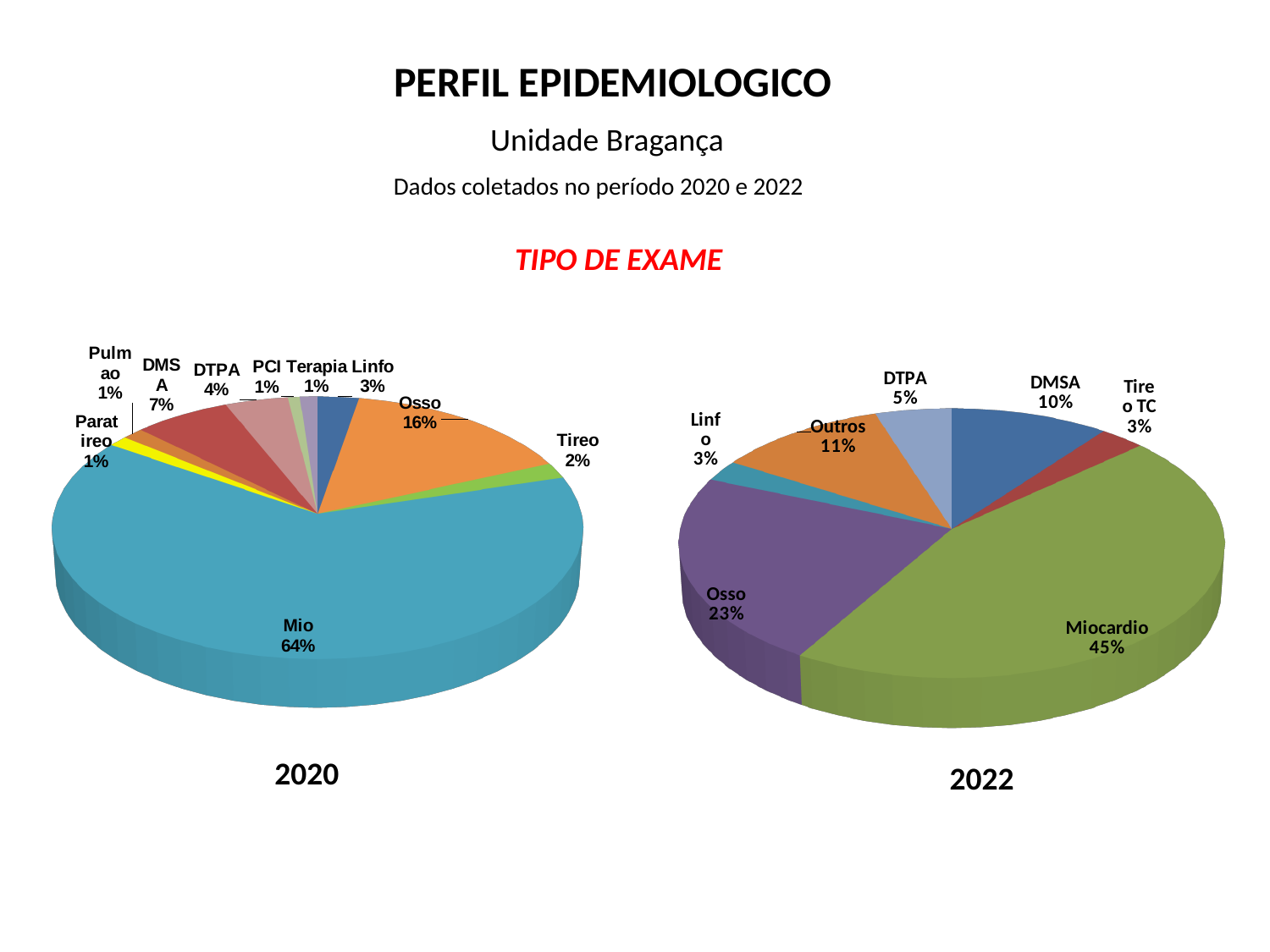
In the 2020 chart, how many slices does the pie have? 10 In the 2022 chart, what share does Outros have? 11% In the 2022 chart, how many slices does the pie have? 7 In the 2020 chart, what share does Osso have? 16% In the 2022 chart, which category has the largest share? Miocardio What kind of chart is the 2020 chart on the left? pie chart In the 2020 chart, what is the difference between the shares of Osso and DTPA? 12% In the 2020 chart, what share does Mio have? 64% In the 2020 chart, which category has the largest share? Mio In the 2022 chart, which is larger, the share of Osso or the share of DMSA? Osso In the 2020 chart, what share does DMSA have? 7% In the 2022 chart, what share does Miocardio have? 45%